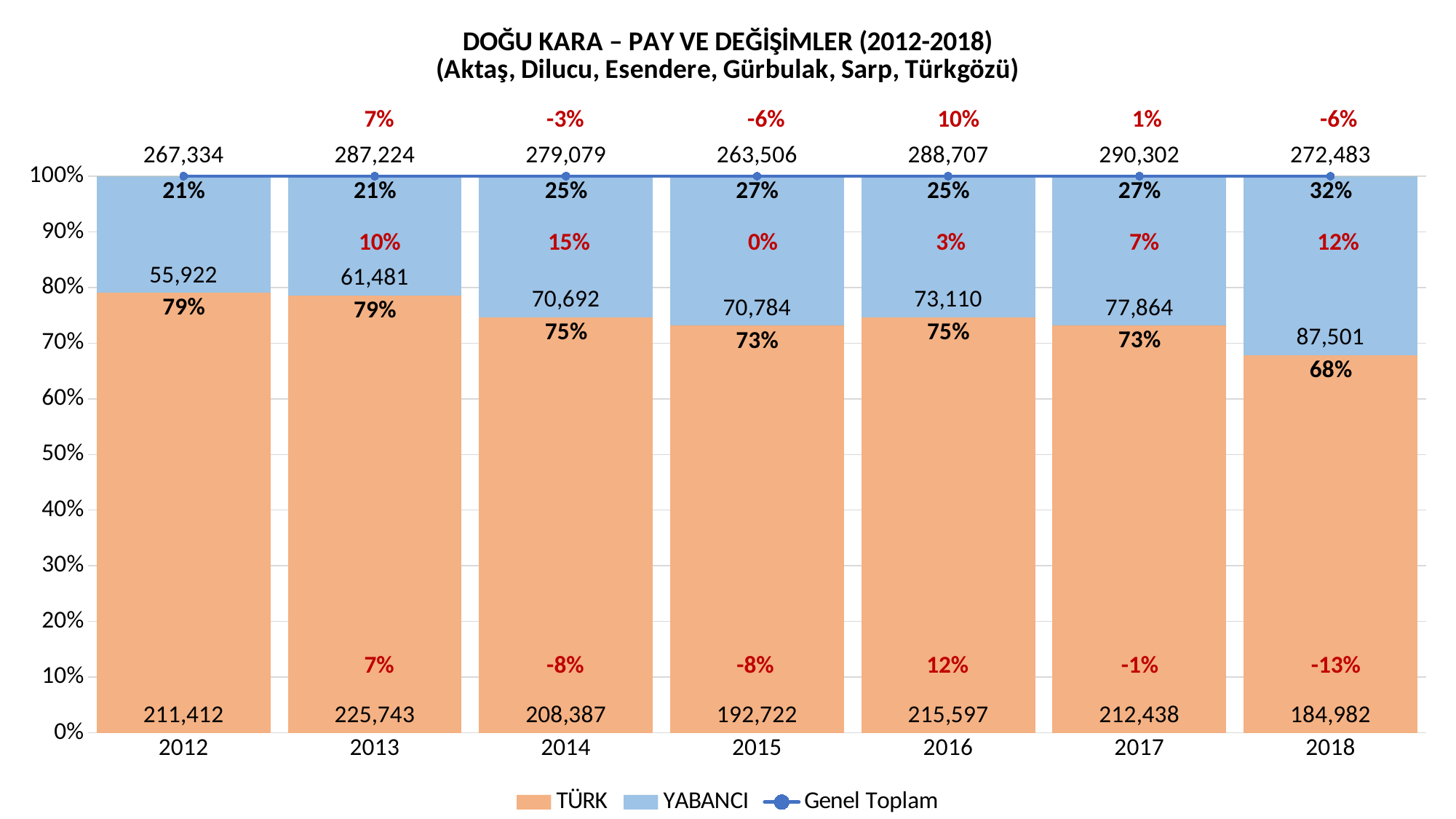
Which is larger, the YABANCI value for 2014 or for 2015? 2015 Which year has the highest Genel Toplam value? 2017 Does the YABANCI share rise or fall from 2012 to 2018? Rise What share of the 2018 bar does TÜRK account for? 68% What is the Genel Toplam value for 2017? 290,302 What is the YABANCI value for 2018? 87,501 How many series does the legend list? 3 What is the TÜRK value for 2015? 192,722 Which year has the lowest TÜRK value? 2018 How many years are shown on the x axis? 7 What kind of chart is this? Stacked bar chart with a line What is the difference between the Genel Toplam values for 2013 and 2012? 19,890